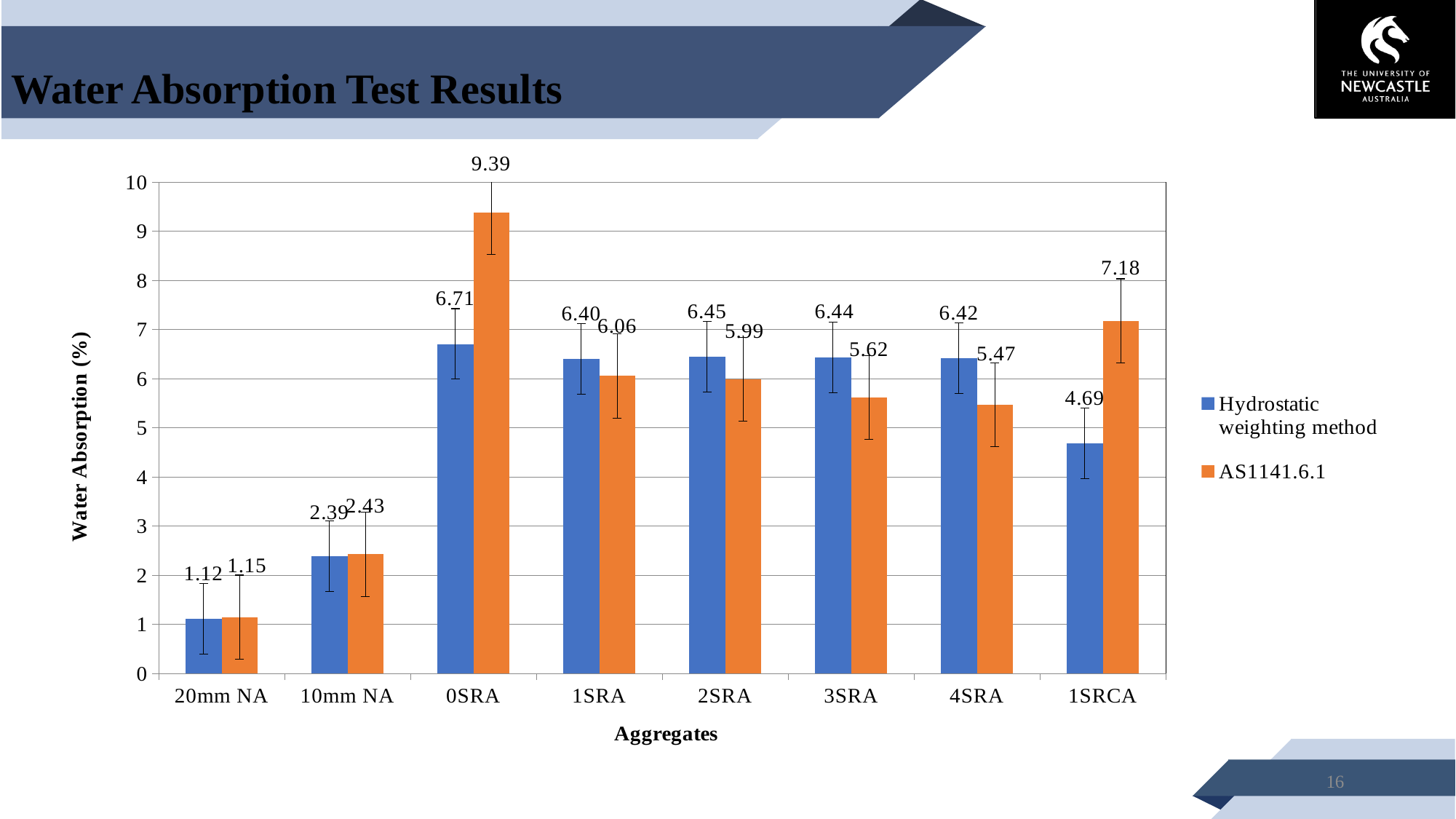
How many series does the legend list? 2 For 1SRCA, which series has the larger value: Hydrostatic weighting method or AS1141.6.1? AS1141.6.1 What is the Hydrostatic weighting method value for 1SRCA? 4.69 Which aggregate has the lowest Hydrostatic weighting method value? 20mm NA What is the difference between the AS1141.6.1 and Hydrostatic weighting method values for 0SRA? 2.68 What kind of chart is shown on the slide? Bar chart What is the AS1141.6.1 value for 3SRA? 5.62 How many aggregate categories are shown on the x axis? 8 What is the difference between the Hydrostatic weighting method values for 10mm NA and 20mm NA? 1.27 What is the label of the y axis? Water Absorption (%) What is the AS1141.6.1 value for 0SRA? 9.39 Which aggregate has the highest AS1141.6.1 value? 0SRA